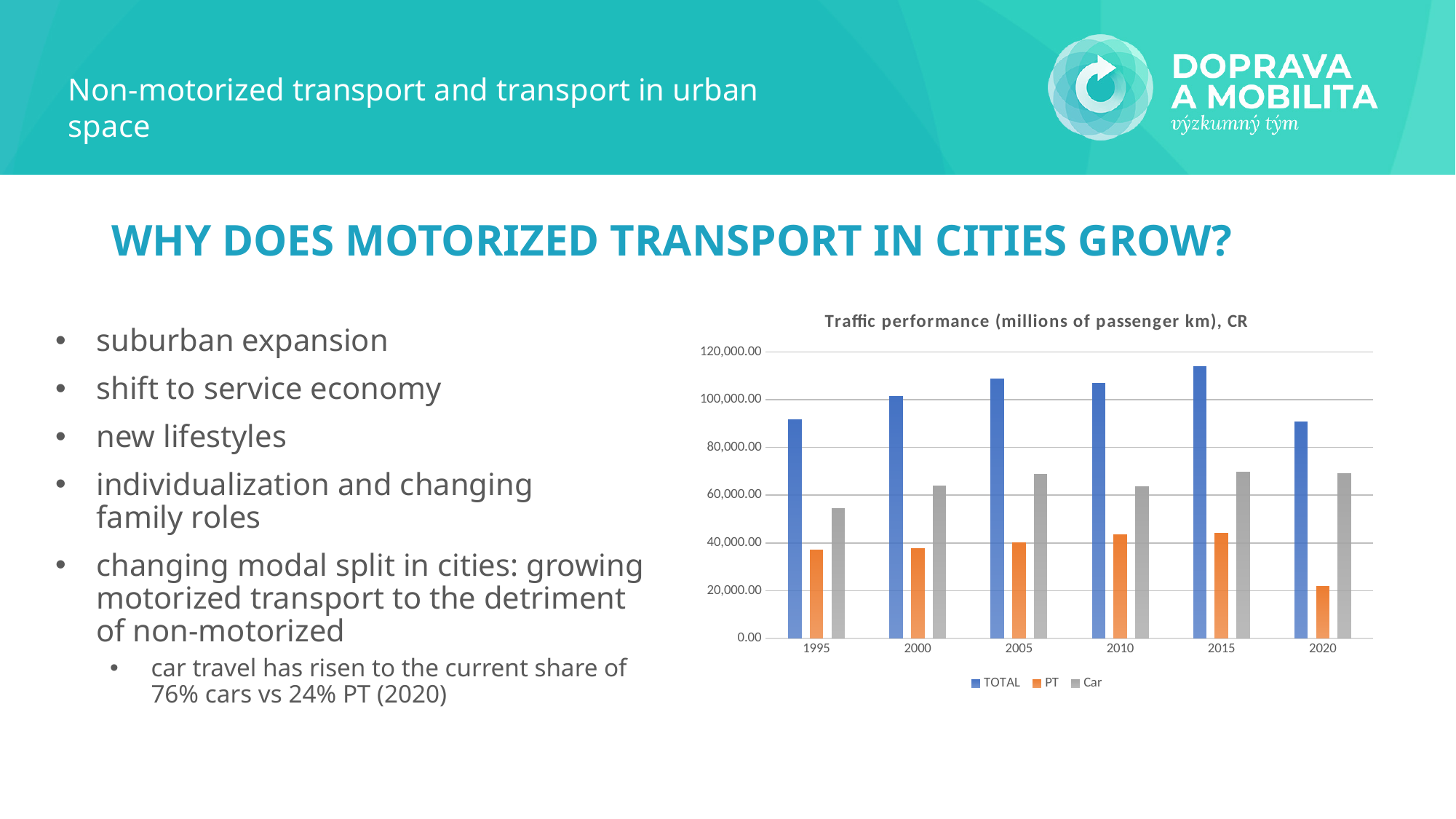
How many series does the chart's legend list? 3 In which year is the TOTAL bar highest? 2015 What kind of chart is shown on the slide? bar chart Is the Car value for 1995 greater or less than 60,000.00? less Is the PT value for 2020 greater or less than 40,000.00? less Is the TOTAL value for 2000 greater or less than 100,000.00? greater In which year is the PT bar lowest? 2020 What is the title of the chart? Traffic performance (millions of passenger km), CR In which year is the Car bar lowest? 1995 In 2020, which is larger, the Car value or the PT value? Car Which series are listed in the chart's legend? TOTAL, PT, Car How many years are shown on the x axis of the chart? 6